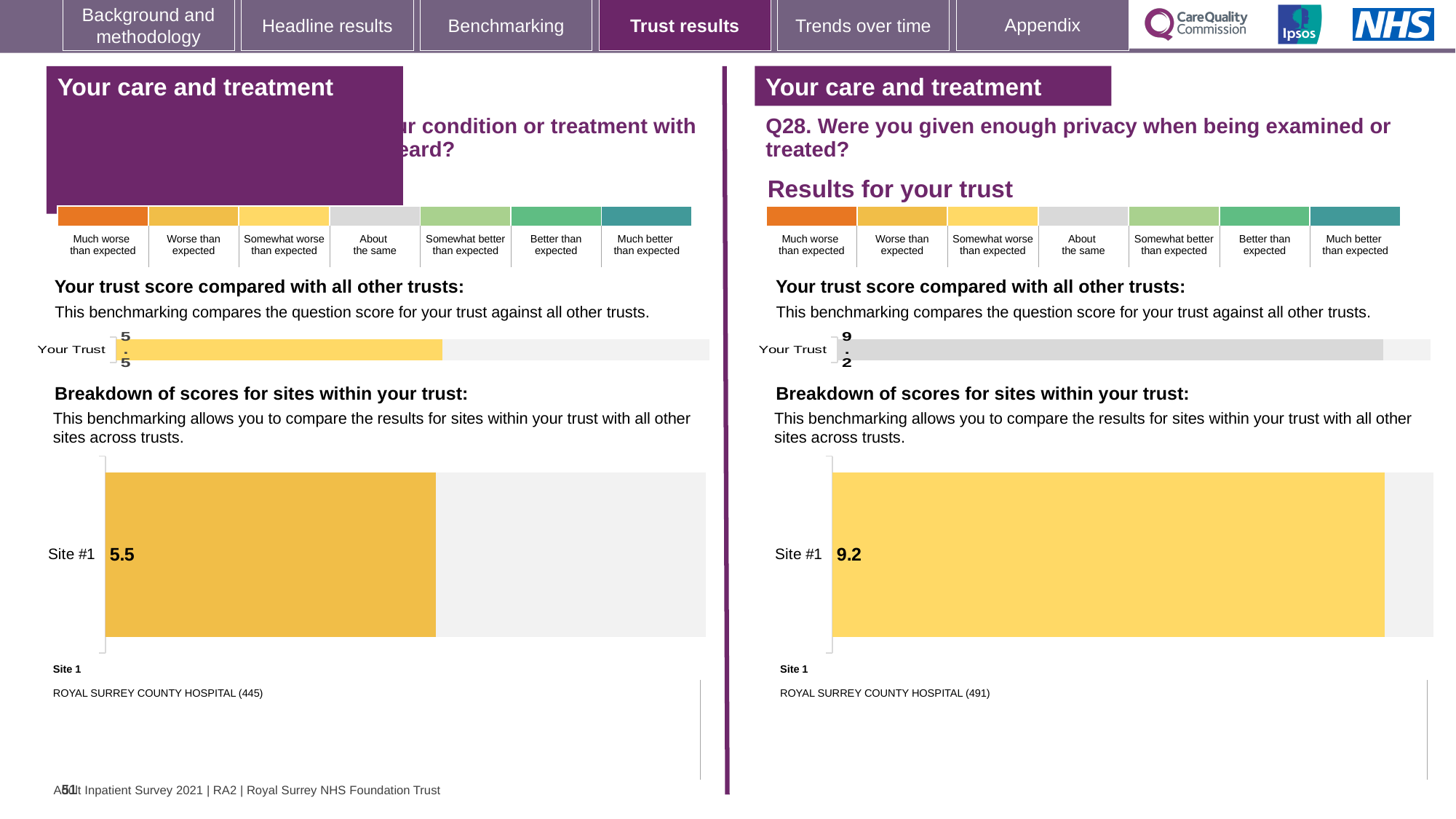
How many sites are shown in the breakdown of scores chart on the right-hand side for Q28? 1 How many sites are shown in the breakdown of scores chart on the left-hand side? 1 On the left-hand chart, what is the score shown for Your Trust? 5.5 On the right-hand chart for Q28 (privacy when being examined or treated), what is the score shown for Your Trust? 9.2 On the left-hand side, which hospital is listed as Site 1? ROYAL SURREY COUNTY HOSPITAL (445) On the left-hand chart, what is the score shown for Site #1? 5.5 On the right-hand chart for Q28, what is the score shown for Site #1? 9.2 What kind of chart is used to show the Site #1 score on the right-hand side for Q28? Bar chart On the right-hand side for Q28, which hospital is listed as Site 1? ROYAL SURREY COUNTY HOSPITAL (491) Which is larger: the Site #1 score on the left-hand chart or the Site #1 score on the right-hand chart for Q28? Site #1 on the right-hand chart (Q28) What is the difference between the Site #1 score on the right-hand chart for Q28 and the Site #1 score on the left-hand chart? 3.7